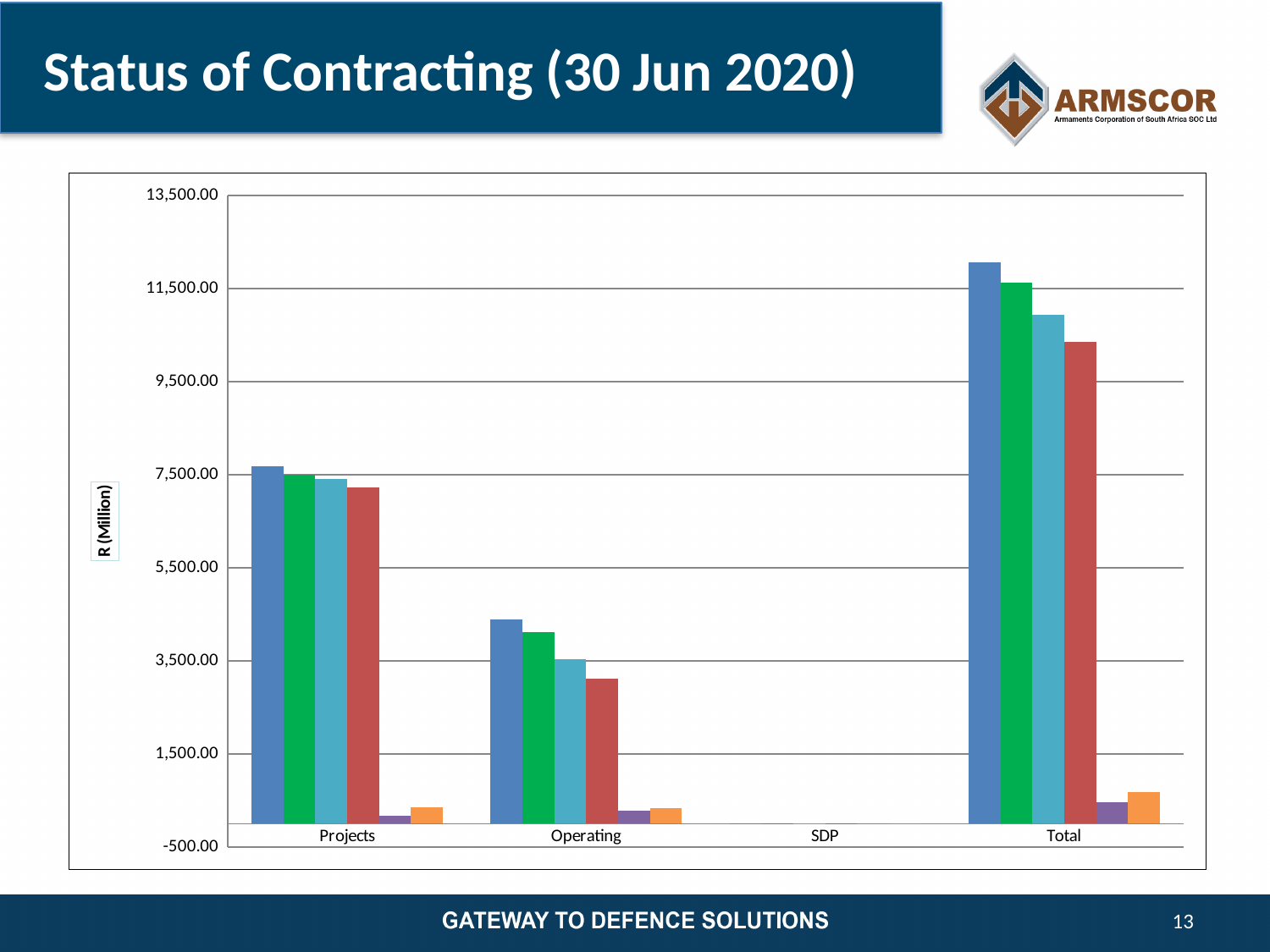
Is the value of the red bar for Projects greater or less than 7,500.00? less Which has the larger dark blue bar, Projects or Operating? Projects What is the label on the vertical axis of the chart? R (Million) How many bars are plotted for the Projects category? 6 Is the value of the dark blue bar for Operating greater or less than 3,500.00? greater Which category on the x axis shows no visible bars? SDP Is the value of the red bar for Total greater or less than 9,500.00? greater Which category on the x axis has the tallest bars? Total How many categories are shown on the x axis of the chart? 4 What kind of chart is shown on the slide? bar chart